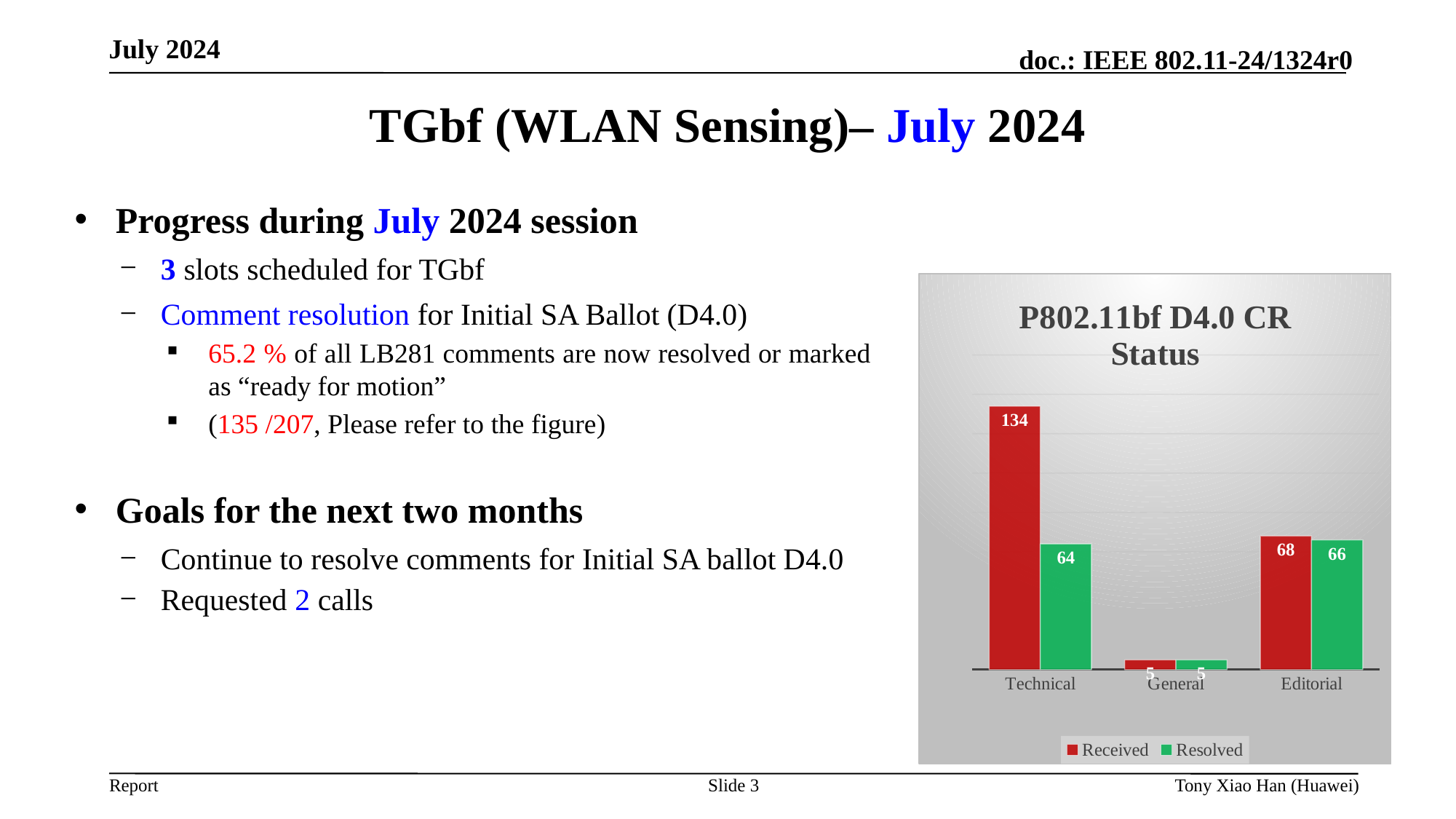
What is the title of the chart? P802.11bf D4.0 CR Status Which category has the highest Received value? Technical Which category has the lowest Resolved value? General Which is larger, the Resolved value for Technical or the Resolved value for Editorial? Resolved value for Editorial What is the Received value for General? 5 What is the Received value for Technical? 134 How many series does the legend list? 2 How many categories are shown on the x axis? 3 What kind of chart is shown? bar chart What is the difference between Received and Resolved for Editorial? 2 What is the Resolved value for Editorial? 66 What is the difference between Received and Resolved for Technical? 70